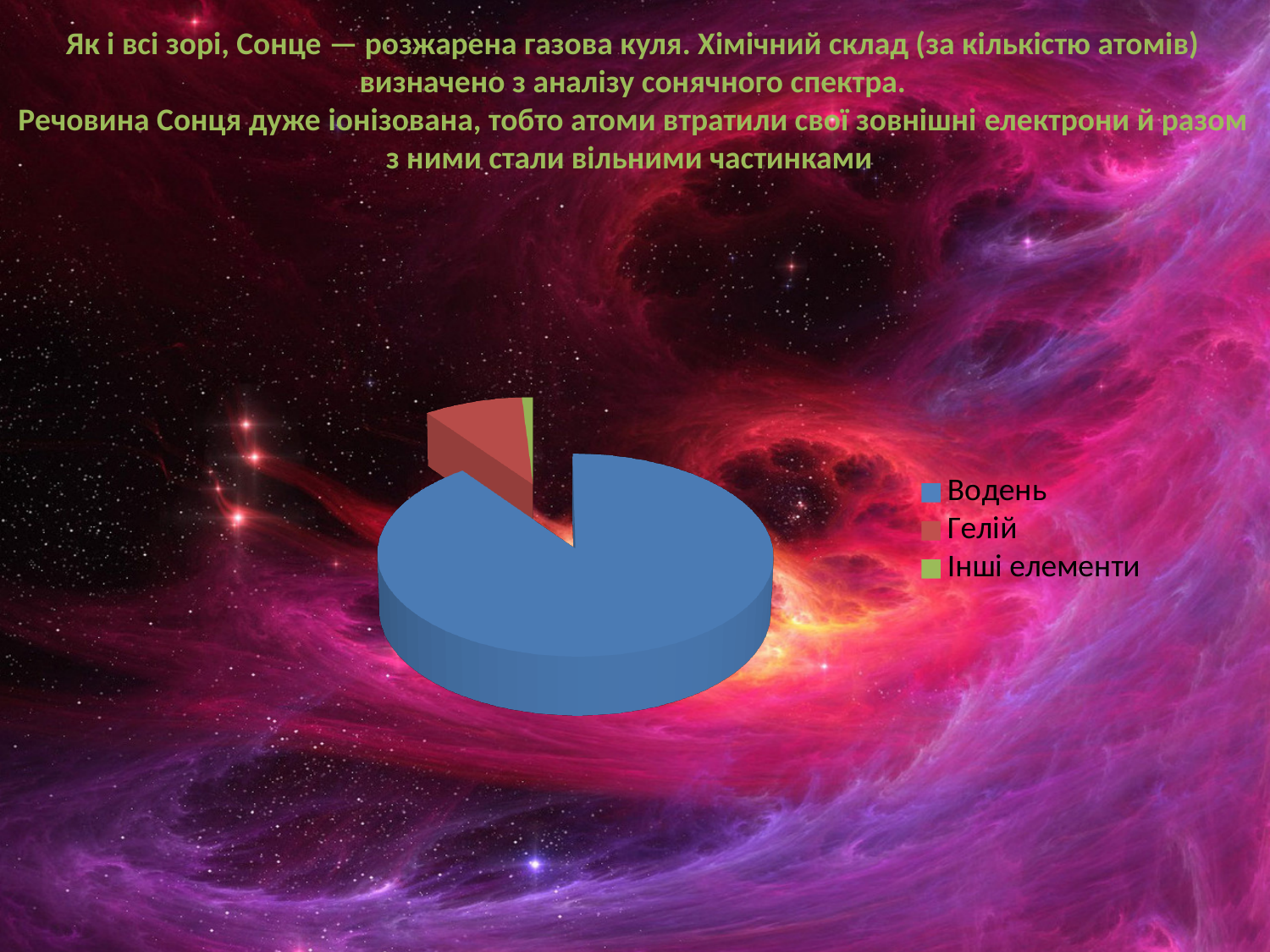
How many slices does the pie chart have? 3 Which category has the largest slice in the pie chart? Водень Which slice is larger in the pie chart, Гелій or Інші елементи? Гелій Which category has the smallest slice in the pie chart? Інші елементи What colour is the Водень slice in the pie chart? blue How many entries does the legend of the pie chart list? 3 Which legend entry is shown in green in the pie chart? Інші елементи Which slice is larger in the pie chart, Водень or Гелій? Водень What kind of chart is shown on the slide? pie chart